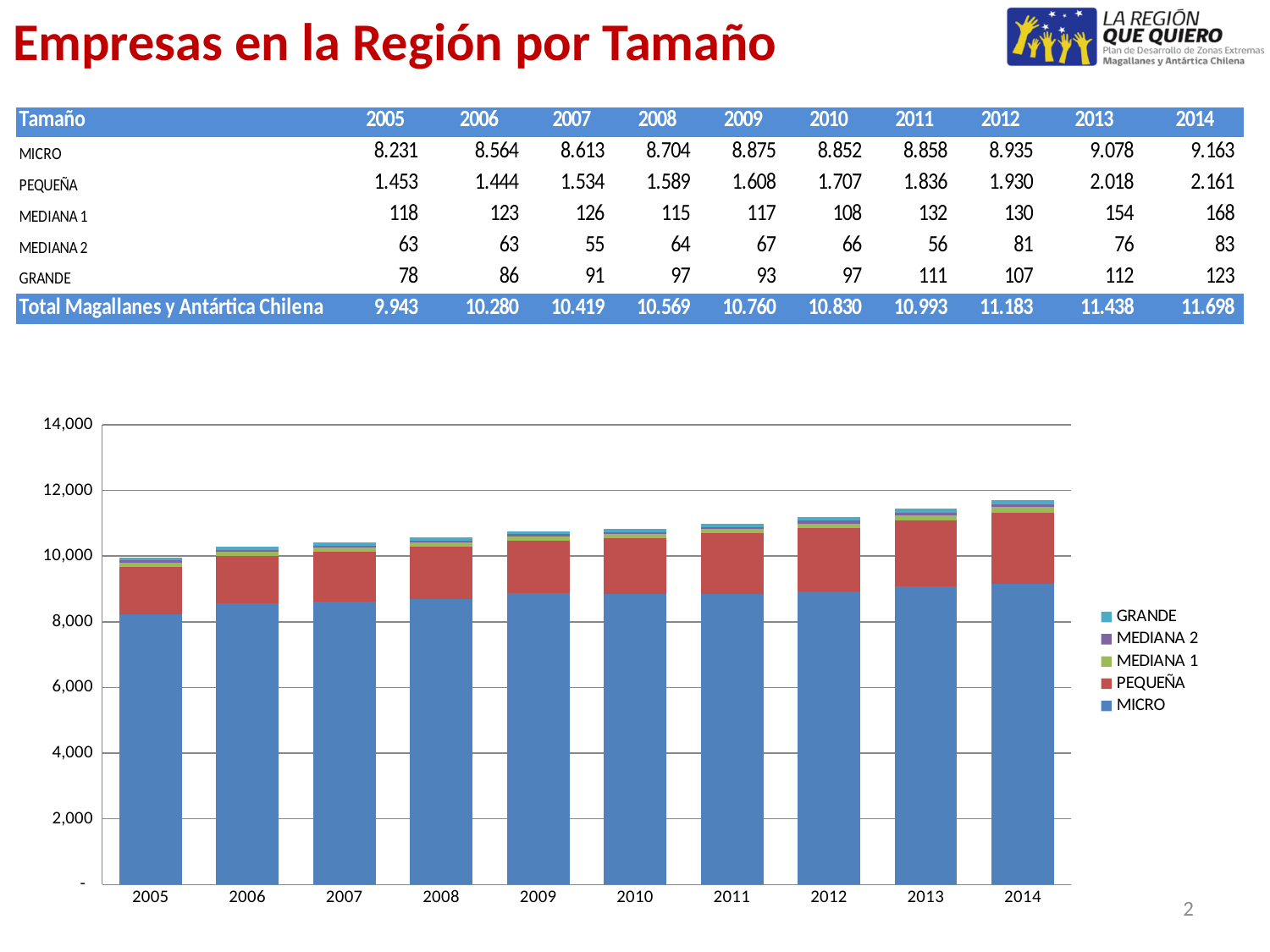
How many years are shown along the x axis of the chart? 10 According to the slide, what is the total for Magallanes y Antártica Chilena in 2005? 9.943 Do the total heights of the stacked bars rise or fall from 2005 to 2014? Rise Which year has the highest total stacked bar in the chart? 2014 How many series does the chart legend list? 5 Is the MICRO value for 2014 greater or less than 8,000? greater Which year has the lowest total stacked bar in the chart? 2005 Is the total value of the stacked bar for 2005 greater or less than 10,000? less According to the slide, what is the MICRO value for 2014? 9.163 Which series forms the largest part of each stacked bar in the chart? MICRO What kind of chart is shown on the slide? Stacked bar chart Is the total value of the stacked bar for 2014 greater or less than 12,000? less